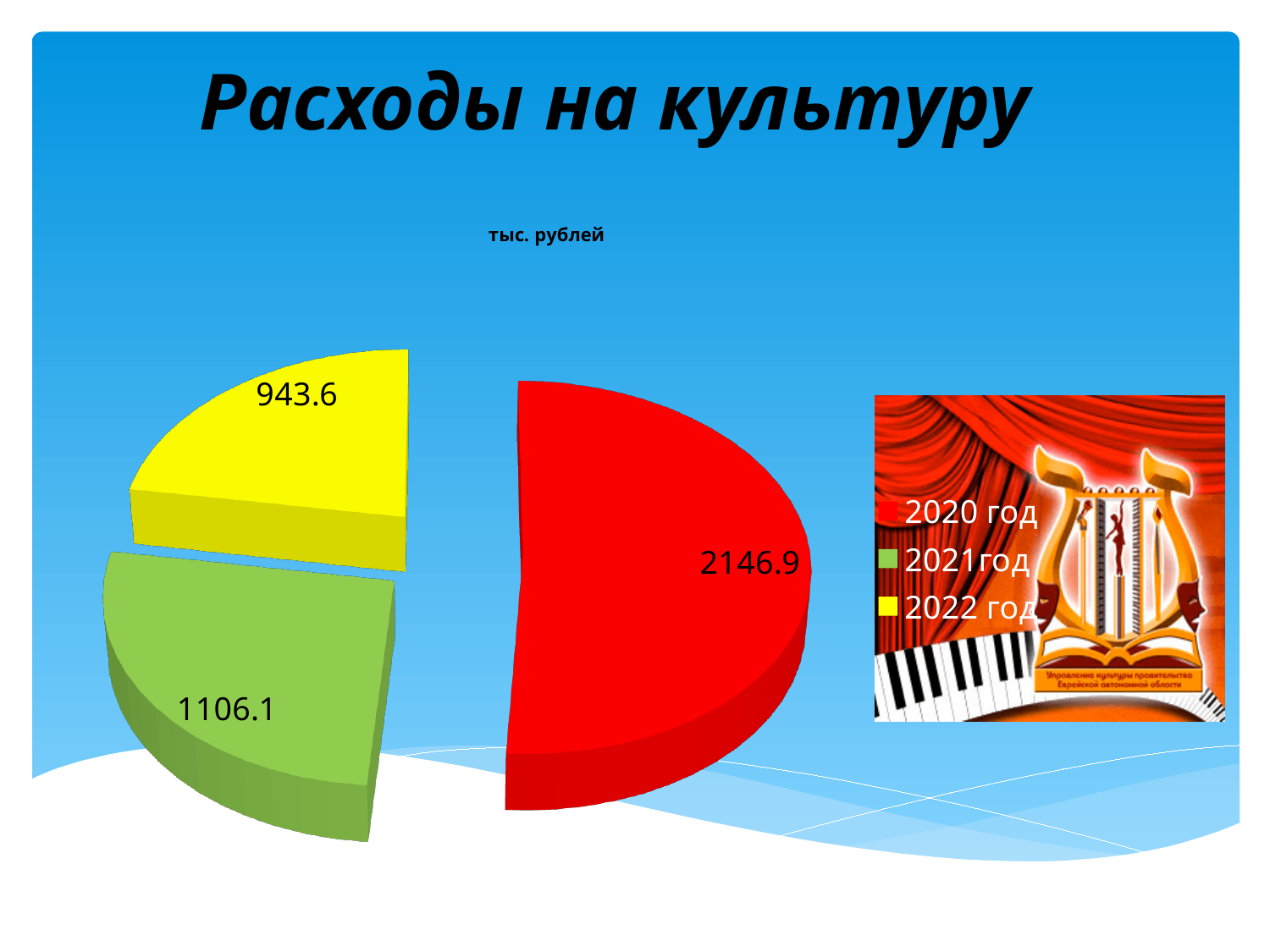
What is the value for 2021 год? 1106.1 Do the values rise or fall from 2020 to 2022? fall What is the title of the slide containing the chart? Расходы на культуру How many slices does the pie chart have? 3 Which year has the smallest slice of the pie? 2022 год What is the difference between the values for 2020 год and 2021 год? 1040.8 What is the value for 2022 год? 943.6 What type of chart is shown on the slide? pie chart What is the difference between the values for 2021 год and 2022 год? 162.5 Which year has the largest slice of the pie? 2020 год Which is larger, the value for 2021 год or the value for 2022 год? 2021 год What is the value for 2020 год? 2146.9